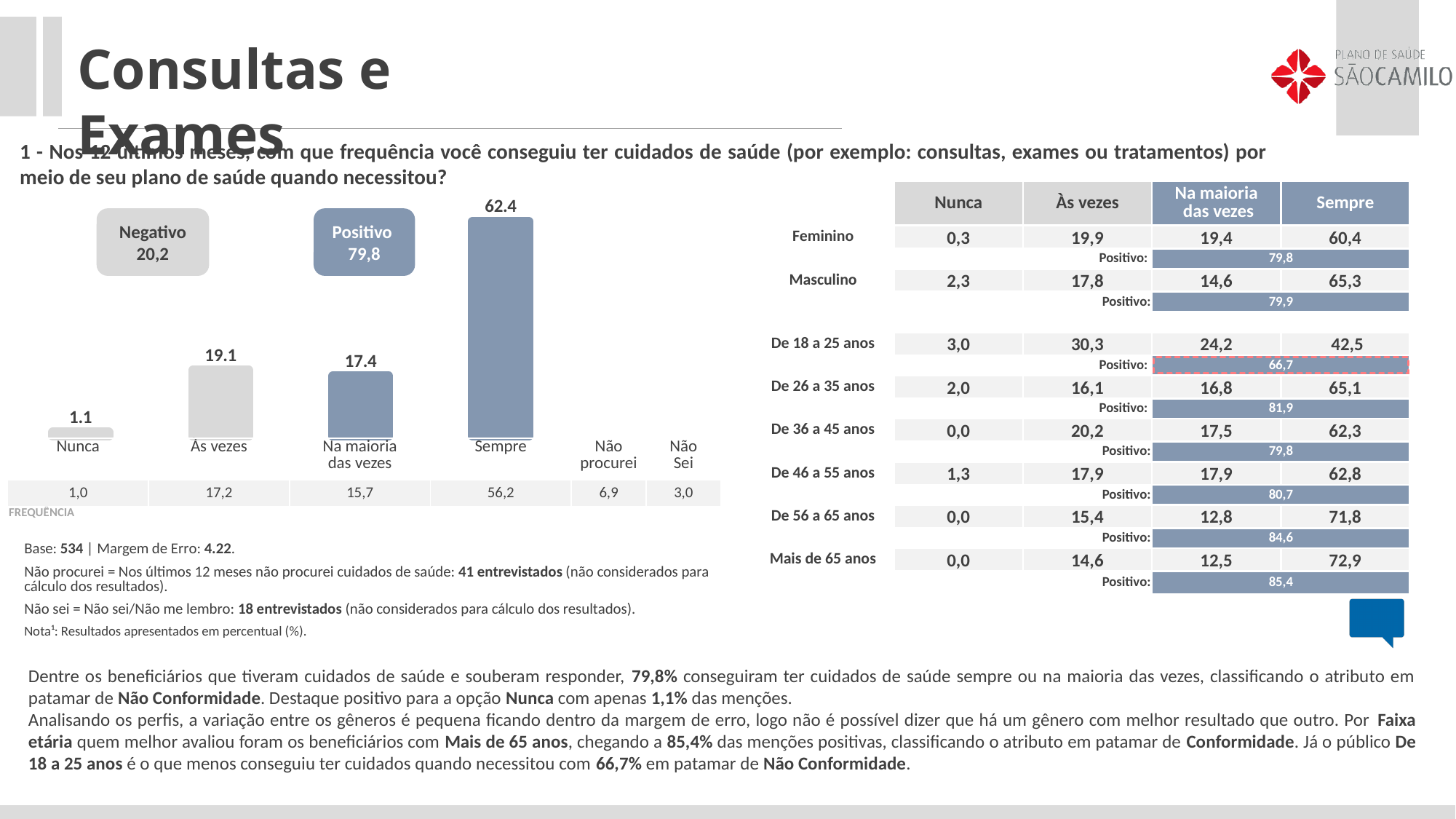
How many bars are plotted in the chart? 4 What is the value of the bar for Sempre? 62.4 What is the value of the bar for Às vezes? 19.1 Which category has the highest bar in the chart? Sempre What is the value of the bar for Na maioria das vezes? 17.4 What type of chart is shown on the left of the slide? bar chart What value is shown in the Positivo box above the chart? 79,8 What is the value of the bar for Nunca? 1.1 Which category has the lowest bar in the chart? Nunca What is the difference between the values for Sempre and Às vezes? 43.3 Which is larger, the bar for Às vezes or the bar for Na maioria das vezes? Às vezes What is the difference between the values for Às vezes and Na maioria das vezes? 1.7